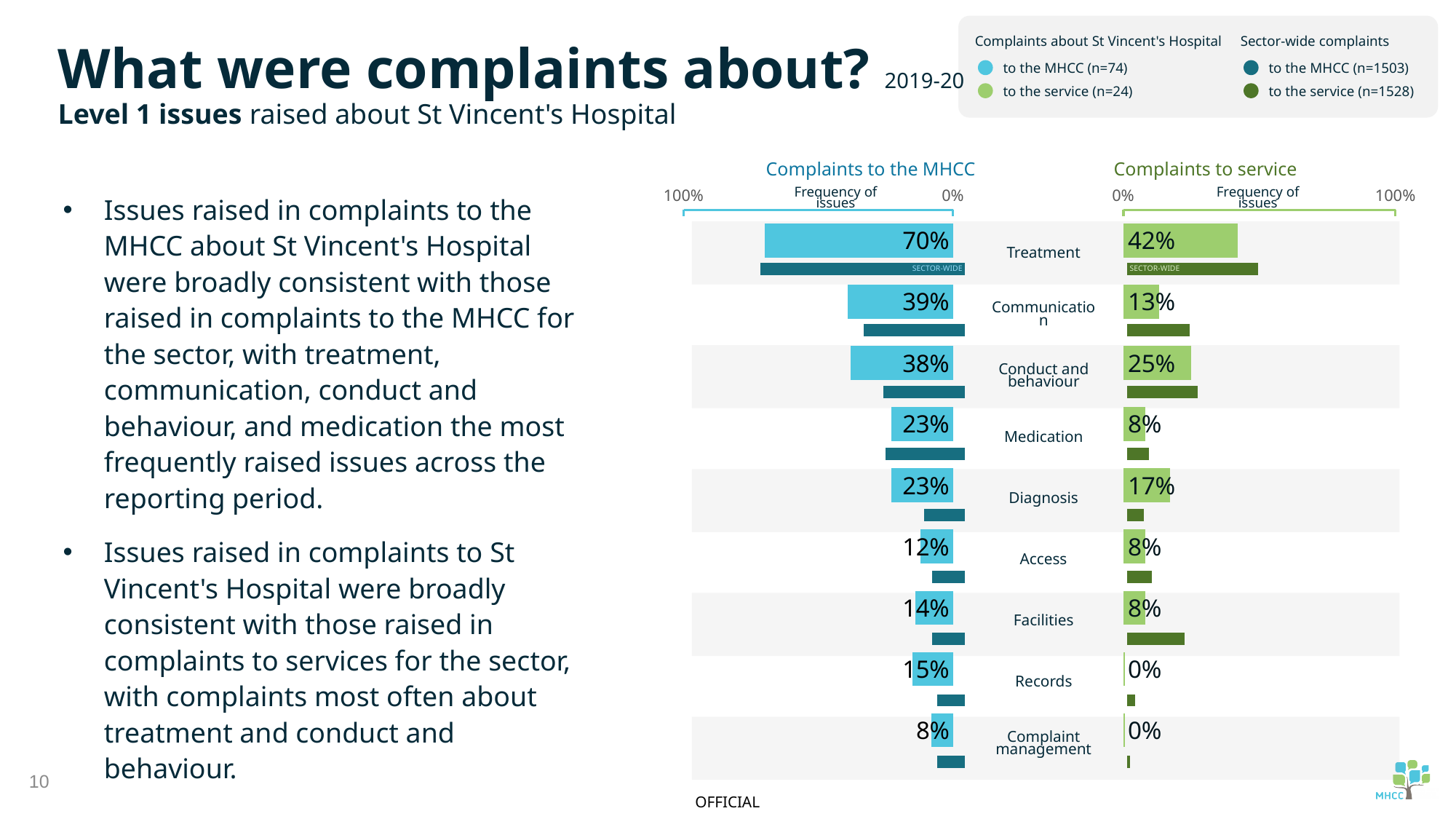
In the 'Complaints to service' chart, what is the value for Conduct and behaviour? 25% What kind of chart is used to show the frequency of issues? Bar chart In the 'Complaints to service' chart, which issue has the highest frequency? Treatment In the 'Complaints to the MHCC' chart, which is larger for St Vincent's Hospital: Medication or Access? Medication In the 'Complaints to service' chart, what is the value for Records? 0% In the 'Complaints to the MHCC' chart, which issue has the highest frequency for St Vincent's Hospital? Treatment In the 'Complaints to the MHCC' chart, what percentage of complaints about St Vincent's Hospital raised Treatment? 70% In the 'Complaints to the MHCC' chart, which issue has the lowest frequency for St Vincent's Hospital? Complaint management How many series does the legend at the top right list? 4 What is the difference between the Treatment value in the 'Complaints to the MHCC' chart and the Treatment value in the 'Complaints to service' chart? 28% In the 'Complaints to the MHCC' chart, what is the value for Communication? 39% How many issue categories are listed in the charts? 9